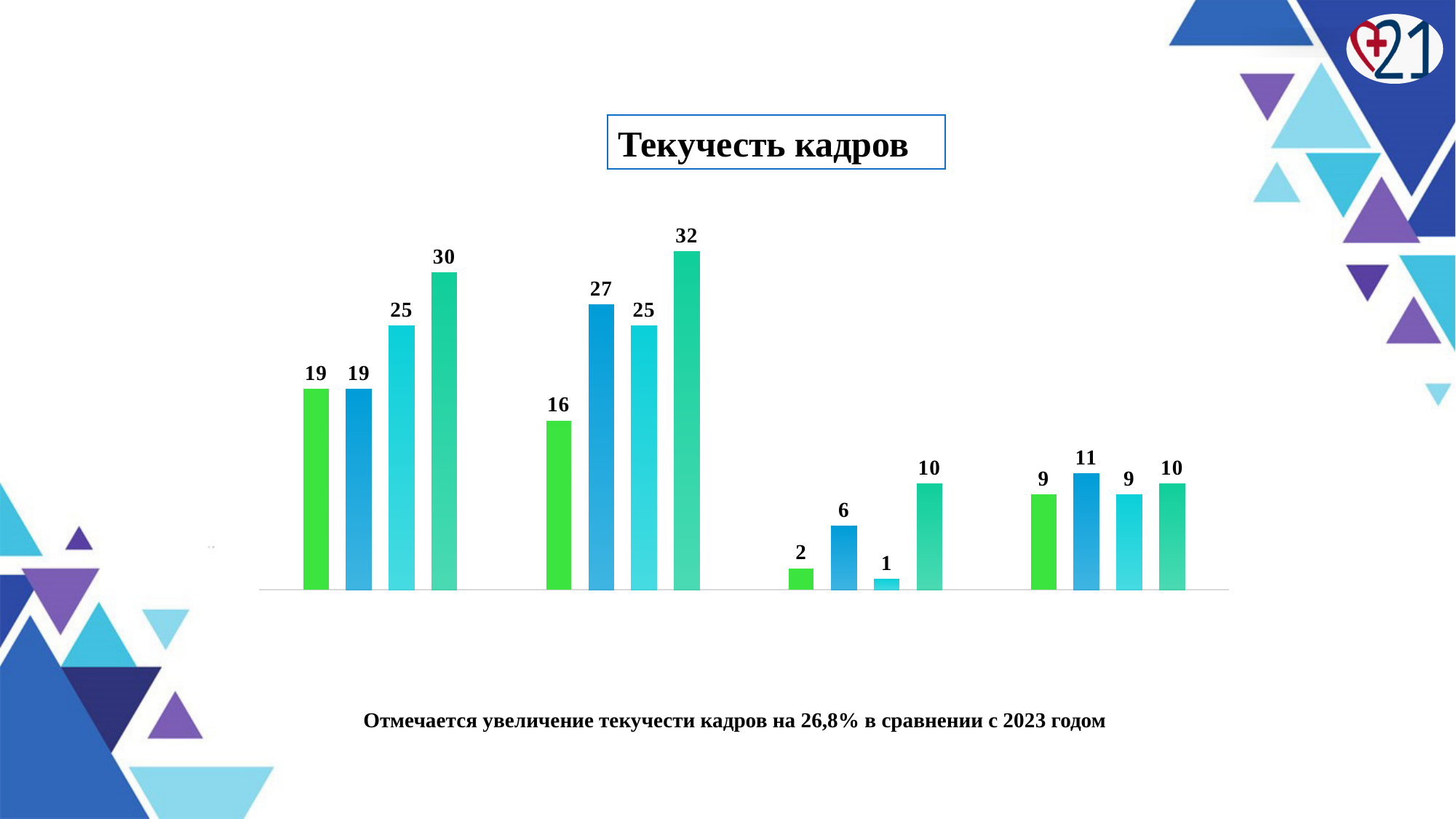
What is the value of the first (green) bar in the leftmost group? 19 How many groups of bars are plotted in the chart? 4 What is the sum of the four bar values in the third group from the left? 19 What is the difference between the last bar of the second group (32) and the last bar of the first group (30)? 2 What is the value of the last (teal) bar in the third group from the left? 10 What is the highest value labelled on any bar in the chart? 32 What is the value of the second (blue) bar in the second group from the left? 27 Which is larger: the third (cyan) bar in the third group or the third (cyan) bar in the fourth group? the fourth group What is the title of the chart? Текучесть кадров How many bars are there in each group of the chart? 4 What is the lowest value labelled on any bar in the chart? 1 What kind of chart is shown on the slide? bar chart